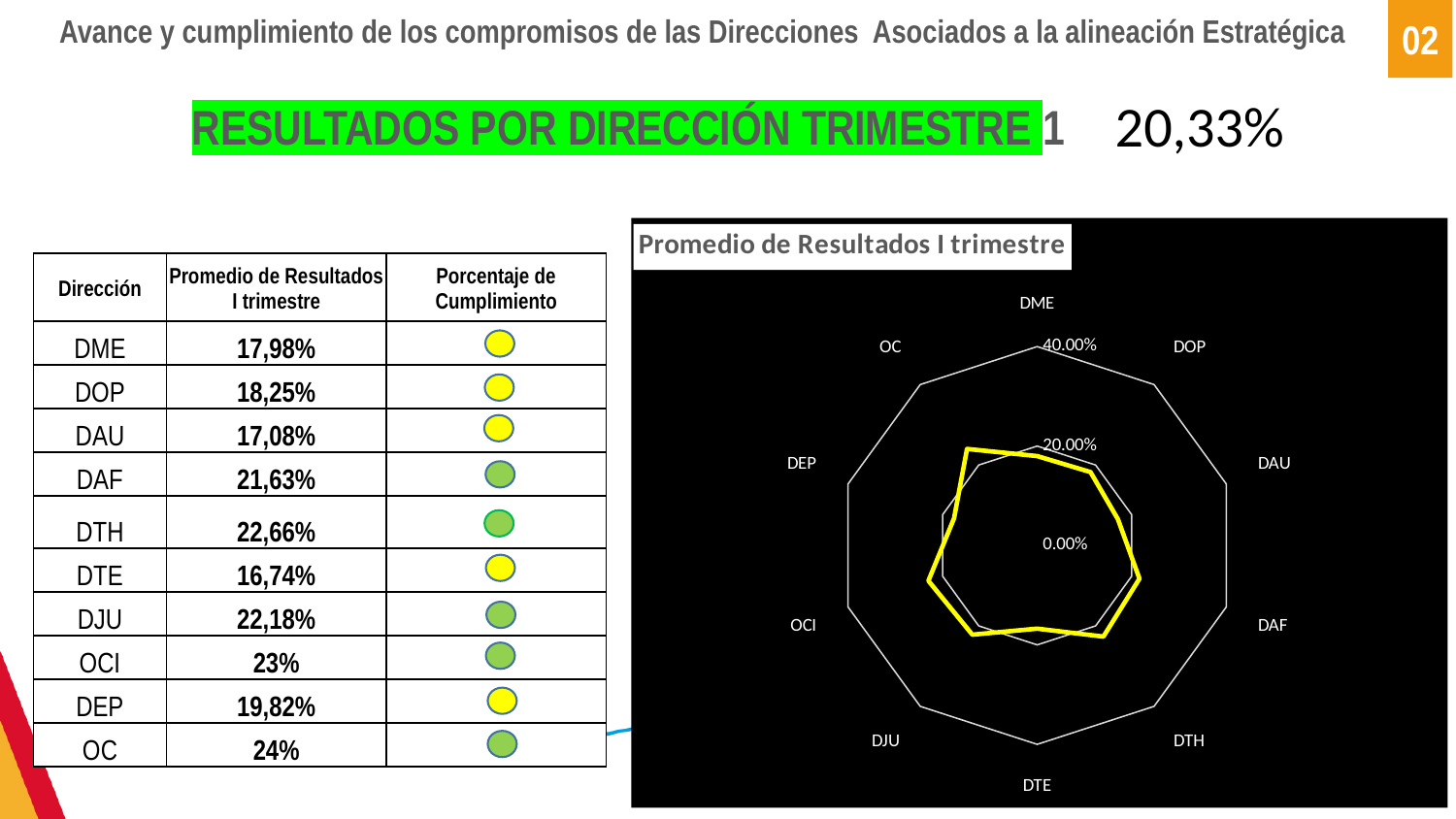
What is the highest value shown on the radar chart's axis scale? 40.00% What kind of chart is shown on the slide? Radar chart According to the slide, what is the Promedio de Resultados I trimestre for DME? 17,98% Is the value for DTE on the radar chart greater or less than 20.00%? less How many categories (direcciones) are plotted on the radar chart? 10 According to the slide, what is the Promedio de Resultados I trimestre for DTH? 22,66% Is the value for OC on the radar chart greater or less than 20.00%? greater What is the title of the chart? Promedio de Resultados I trimestre Which dirección has the highest Promedio de Resultados I trimestre? OC Which dirección has the lowest Promedio de Resultados I trimestre? DTE Is the value for DTH on the radar chart greater or less than 20.00%? greater